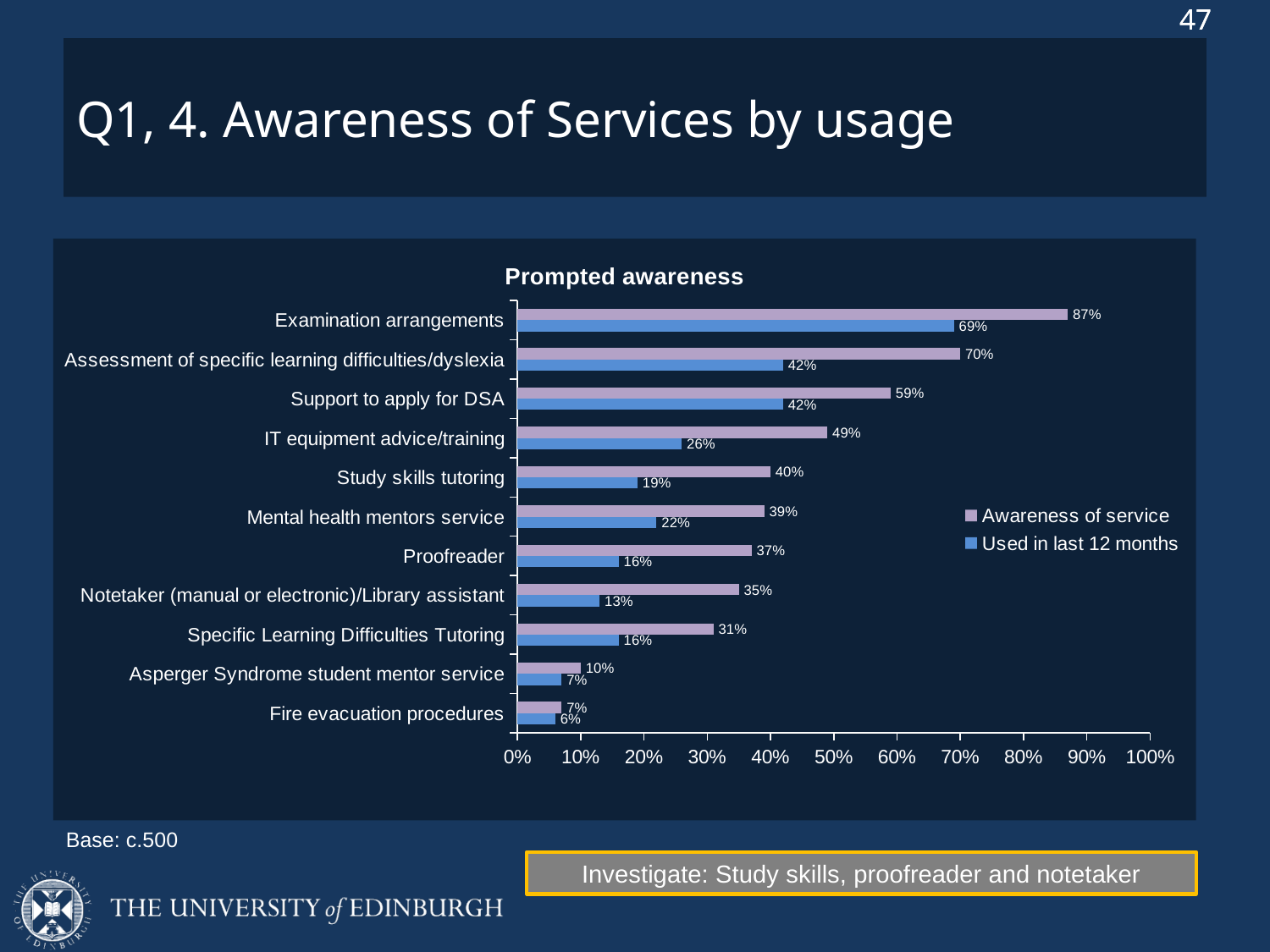
What is the 'Awareness of service' value for Examination arrangements? 87% What is the 'Awareness of service' value for Support to apply for DSA? 59% What kind of chart is shown on the slide? Bar chart What is the difference between the 'Awareness of service' and 'Used in last 12 months' values for Proofreader? 21% Which category has the highest 'Awareness of service' value? Examination arrangements Which is larger: the 'Used in last 12 months' value for IT equipment advice/training or for Mental health mentors service? IT equipment advice/training Which category has the lowest 'Used in last 12 months' value? Fire evacuation procedures What is the 'Used in last 12 months' value for Study skills tutoring? 19% How many series does the legend list? 2 What is the title of the chart? Prompted awareness What is the 'Used in last 12 months' value for Notetaker (manual or electronic)/Library assistant? 13% How many categories are shown on the chart? 11